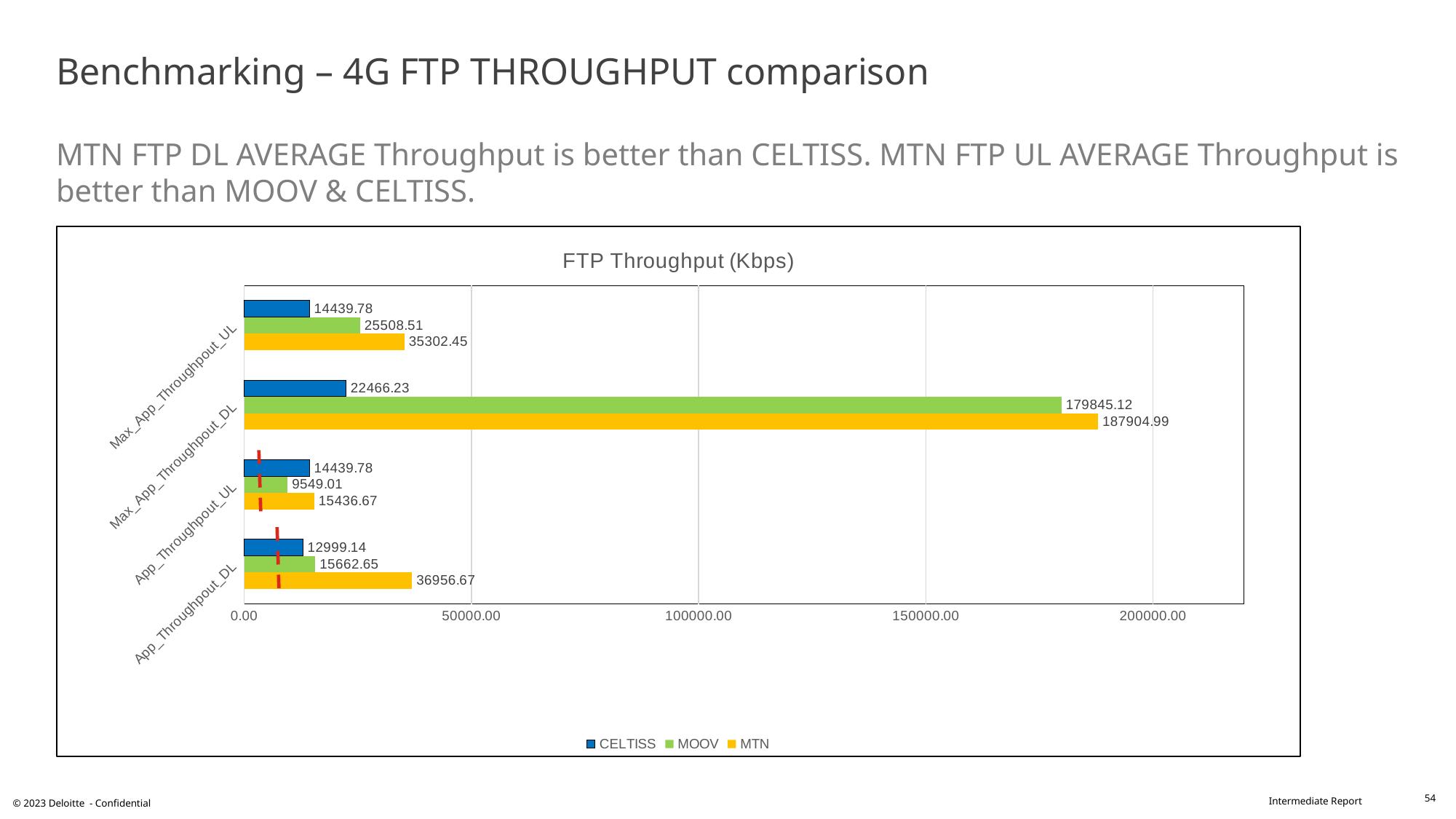
Is the MOOV value for Max_App_Throughpout_DL greater or less than 150000.00? greater What is the CELTISS value for Max_App_Throughpout_UL? 14439.78 How many categories are shown on the vertical axis of the chart? 4 What is the MTN value for App_Throughpout_DL? 36956.67 Which series has the lowest value for App_Throughpout_UL? MOOV Which is larger for App_Throughpout_DL: the MOOV value or the CELTISS value? MOOV What type of chart is shown on the slide? Bar chart Which series has the highest value for Max_App_Throughpout_DL? MTN What is the difference between the MTN and MOOV values for Max_App_Throughpout_DL? 8059.87 How many series does the legend list? 3 What is the MOOV value for App_Throughpout_UL? 9549.01 What is the MTN value for Max_App_Throughpout_DL in the FTP Throughput (Kbps) chart? 187904.99